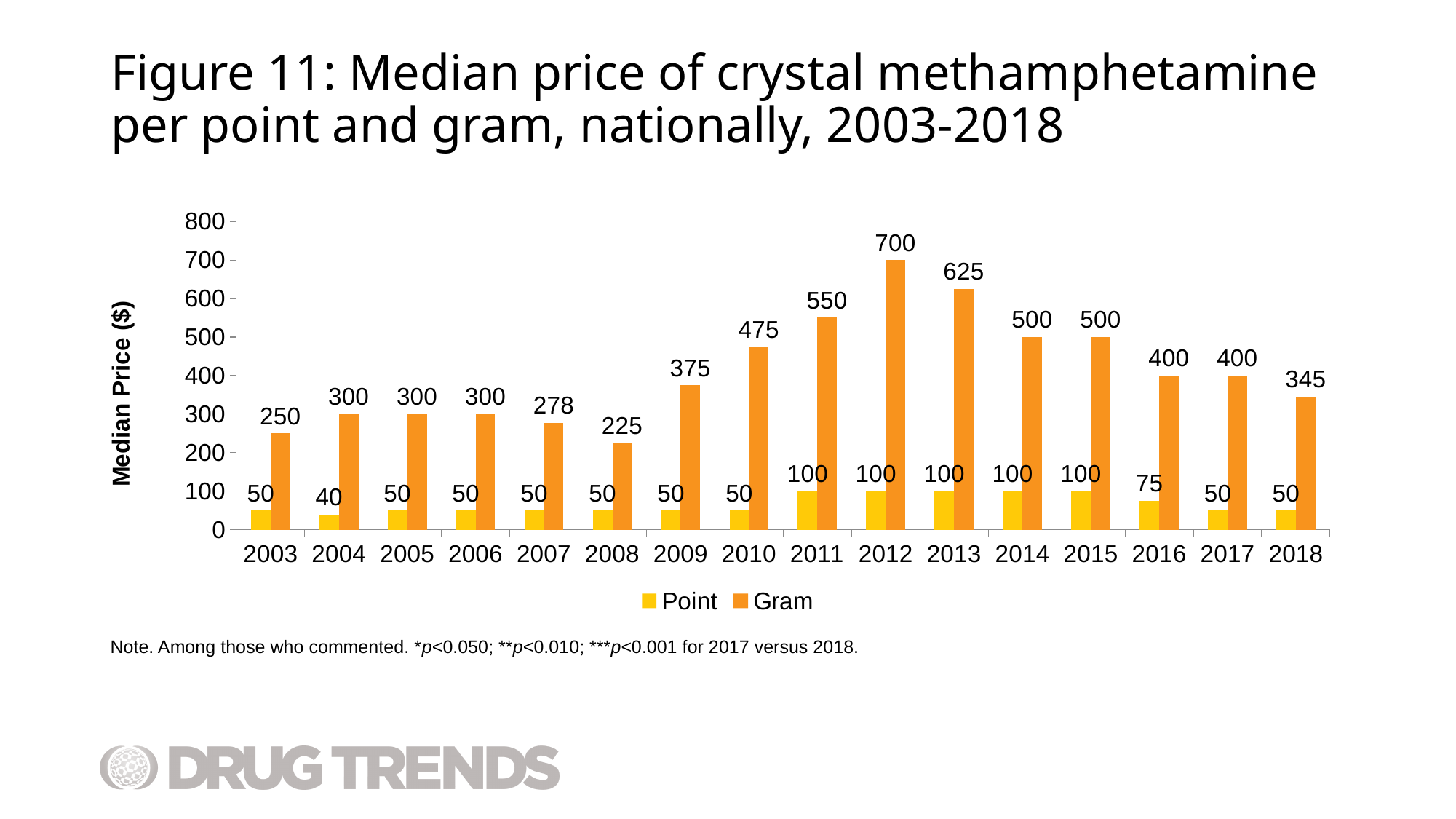
What is the difference between the median price per gram in 2017 and in 2018? 55 In which year was the median price per gram highest? 2012 Which was higher, the median price per gram in 2009 or in 2010? 2010 What was the median price per gram in 2018? 345 What was the median price per point in 2004? 40 How many years are shown on the x axis? 16 What is the difference between the median price per gram in 2012 and in 2013? 75 In which year was the median price per gram lowest? 2008 What was the median price per gram in 2012? 700 How many series does the legend list? 2 What is the label of the y axis? Median Price ($) What kind of chart is shown on the slide? Bar chart